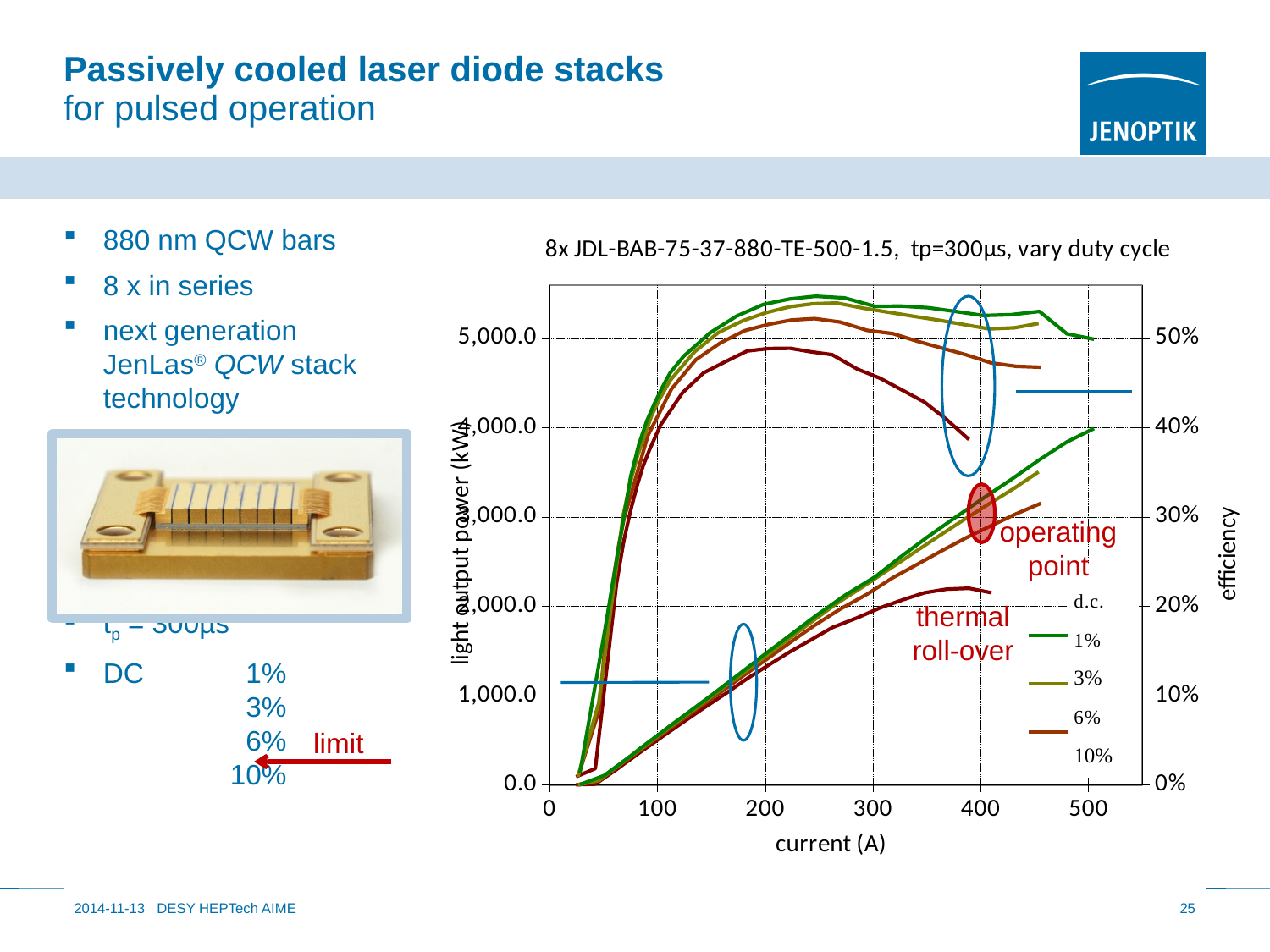
Is the peak light output power for the 10% duty cycle greater or less than 4,000.0? less What kind of chart is shown on the slide? line chart What is the label of the x axis of the chart? current (A) Is the maximum efficiency reached by the 10% duty cycle greater or less than 30%? greater Which duty cycle reaches the highest peak light output power? 1% Which duty cycle has the higher light output power at 400 A, 1% or 10%? 1% Which duty-cycle values are listed in the chart legend? 1%, 3%, 6%, 10% How many duty-cycle series does the chart legend list? 4 Does the light output power for the 10% duty cycle rise or fall as current increases beyond about 200 A? rise Which duty cycle has the lowest peak light output power? 10% Is the efficiency for the 1% duty cycle at 500 A greater or less than 30%? greater